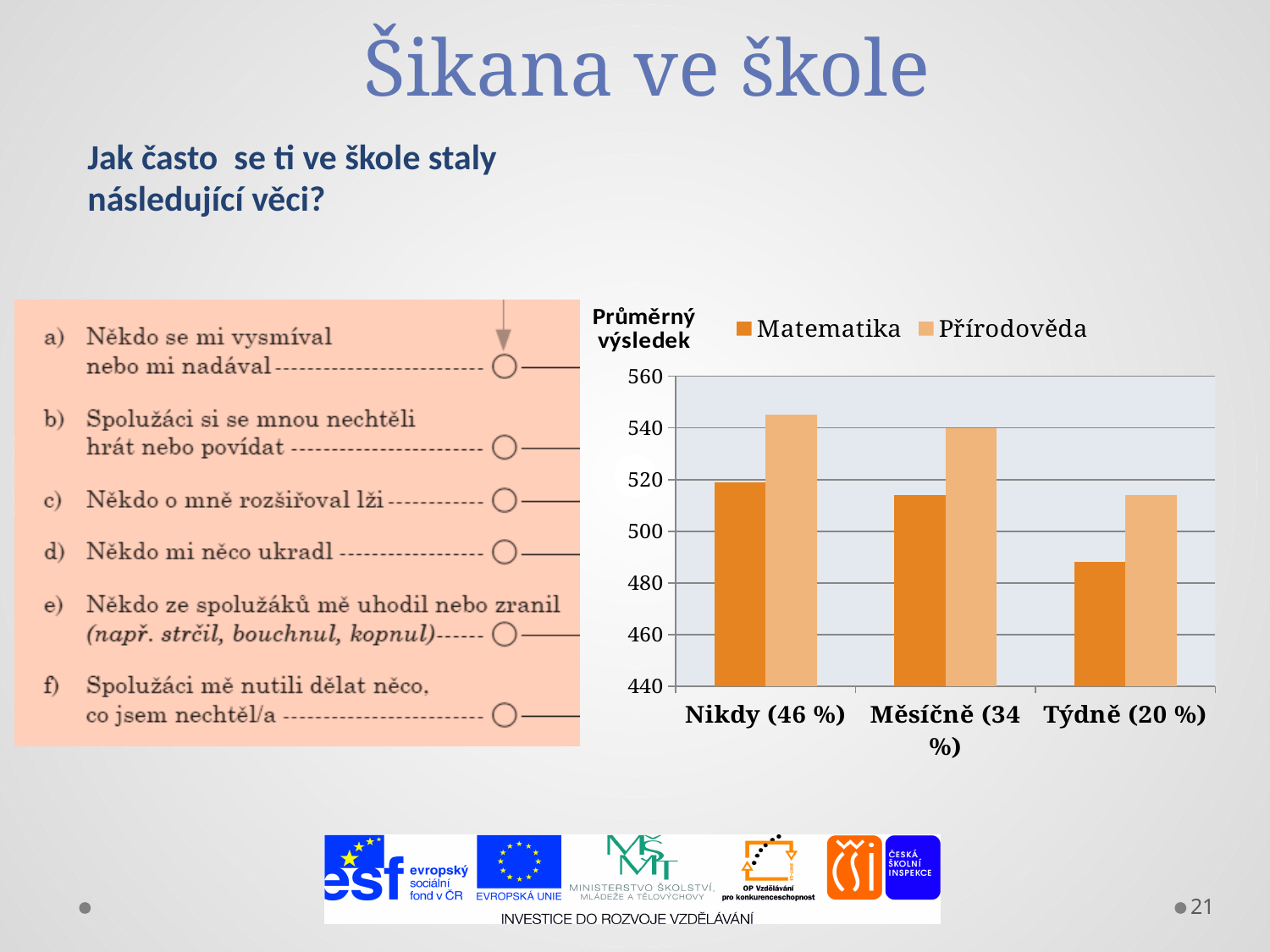
Do the Matematika values rise or fall from Nikdy (46 %) to Týdně (20 %)? fall Which category has the highest Přírodověda bar? Nikdy (46 %) For the category Nikdy (46 %), which series has the larger value, Matematika or Přírodověda? Přírodověda How many series does the chart legend list? 2 Is the Přírodověda value for Týdně (20 %) greater or less than 500? greater What is the label on the vertical axis of the chart? Průměrný výsledek Is the Matematika value for Týdně (20 %) greater or less than 500? less Which category has the lowest Matematika bar? Týdně (20 %) Is the Přírodověda value for Měsíčně (34 %) greater or less than 520? greater How many categories are shown on the x axis of the chart? 3 What kind of chart is shown on the slide? bar chart